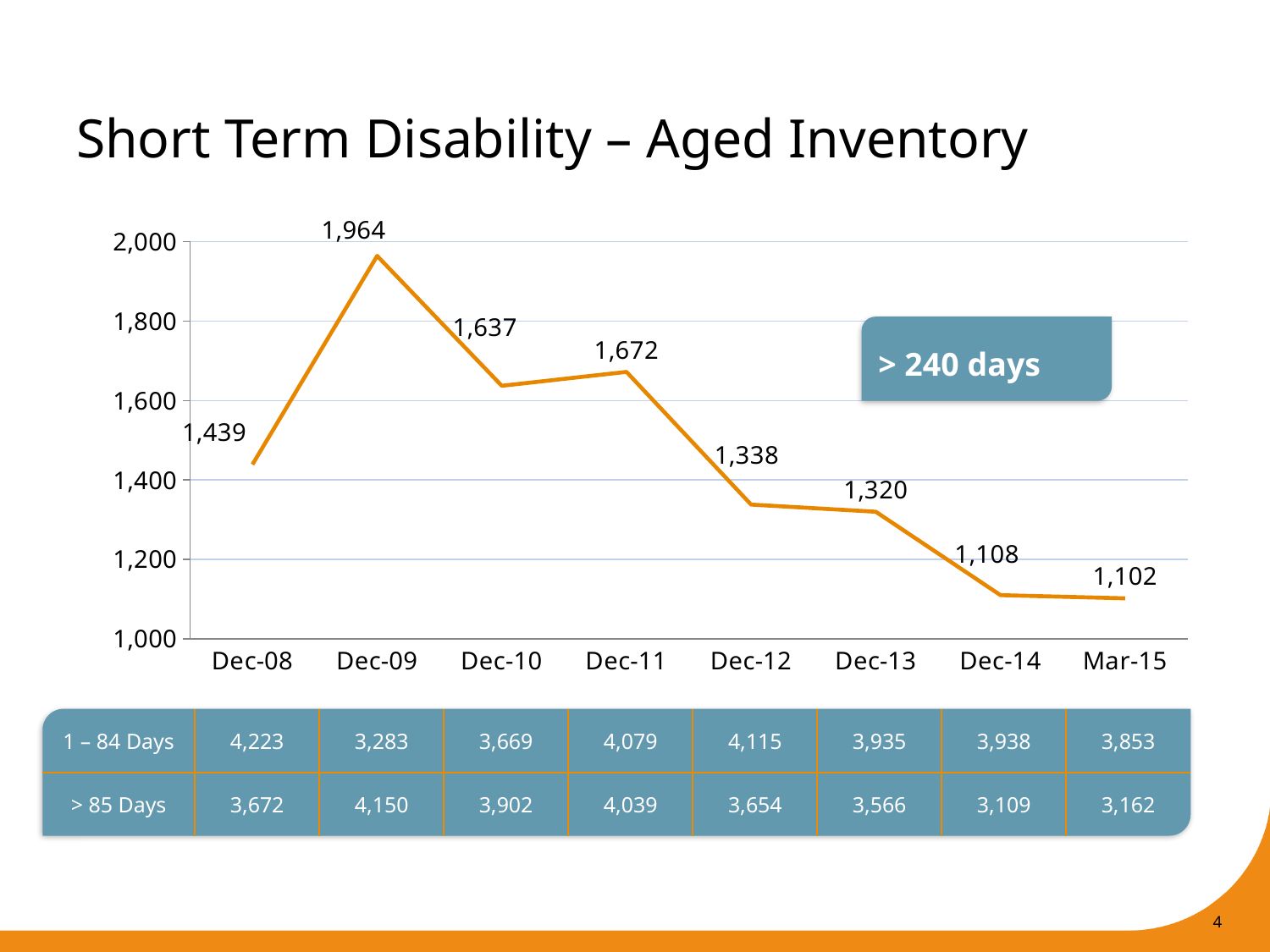
How many time periods are plotted on the line chart? 8 Does the line chart rise or fall from Dec-11 to Mar-15? fall What is the difference between the Dec-09 and Dec-08 values on the line chart? 525 Which is larger on the line chart, the value for Dec-10 or Dec-11? Dec-11 What is the value for Dec-12 on the line chart? 1,338 What kind of chart is shown on the slide? line chart Is the value for Dec-13 on the line chart greater or less than 1,400? less What is the value for Dec-09 on the line chart? 1,964 What is the value for Mar-15 on the line chart? 1,102 What is the difference between the Dec-11 and Dec-12 values on the line chart? 334 Which period has the lowest value on the line chart? Mar-15 Which period has the highest value on the line chart? Dec-09